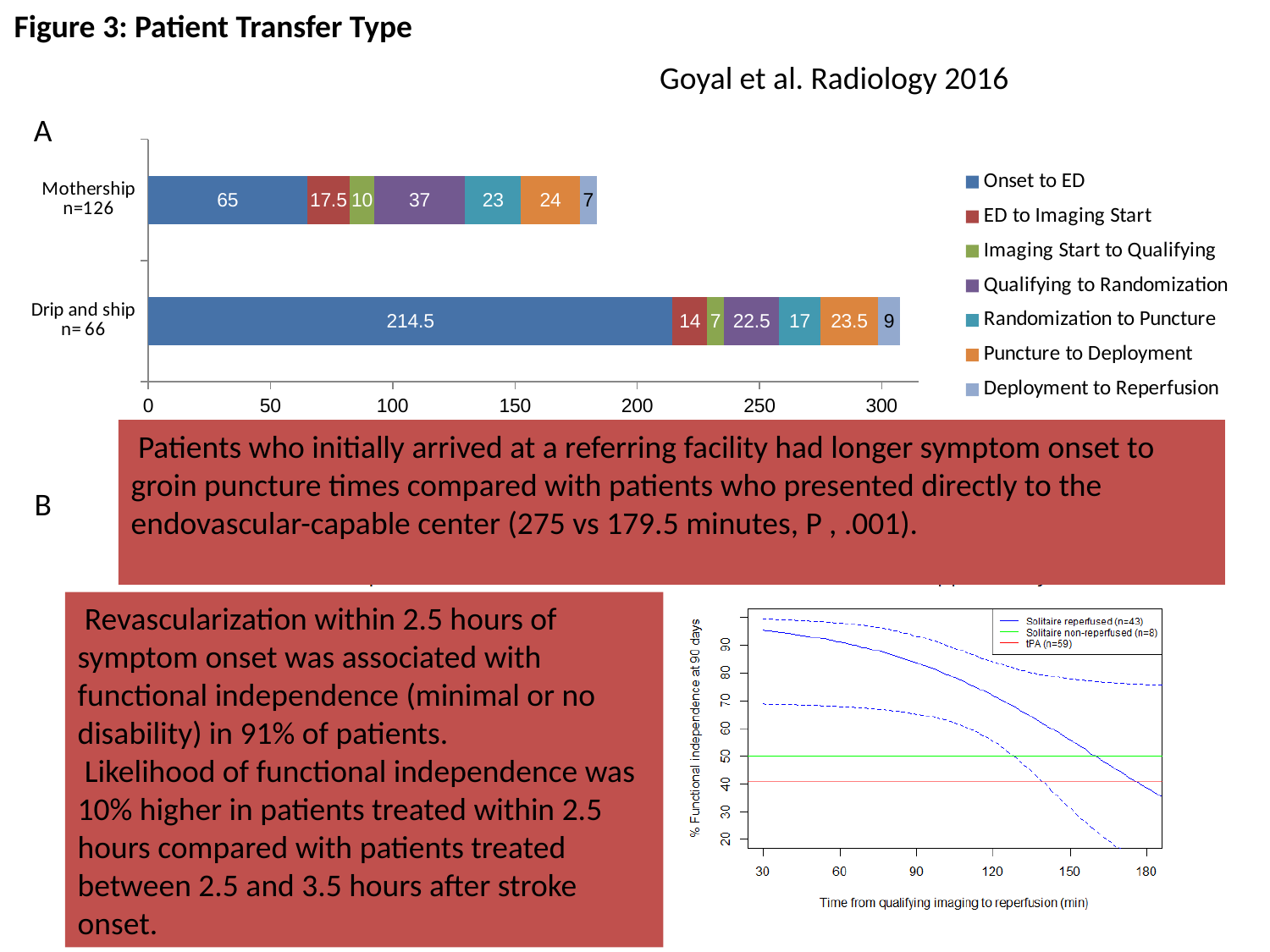
In the stacked bar chart (panel A), what is the difference between the Onset to ED values for Drip and ship and Mothership? 149.5 In the stacked bar chart (panel A), what is the total of the Drip and ship bar? 307.5 In the stacked bar chart (panel A), what is the total of the Mothership bar? 183.5 What kind of chart is panel A? Stacked bar chart In the stacked bar chart (panel A), which category has the larger Onset to ED value, Mothership or Drip and ship? Drip and ship In the stacked bar chart (panel A), what is the Deployment to Reperfusion value for Drip and ship? 9 How many series does the legend of the stacked bar chart (panel A) list? 7 How many categories are shown in the stacked bar chart (panel A)? 2 What is the x-axis label of the line chart in the lower right (panel B)? Time from qualifying imaging to reperfusion (min) In the stacked bar chart (panel A), what is the ED to Imaging Start value for Mothership? 17.5 In the stacked bar chart (panel A), what is the Qualifying to Randomization value for Mothership? 37 In the stacked bar chart (panel A), what is the Onset to ED value for Drip and ship? 214.5